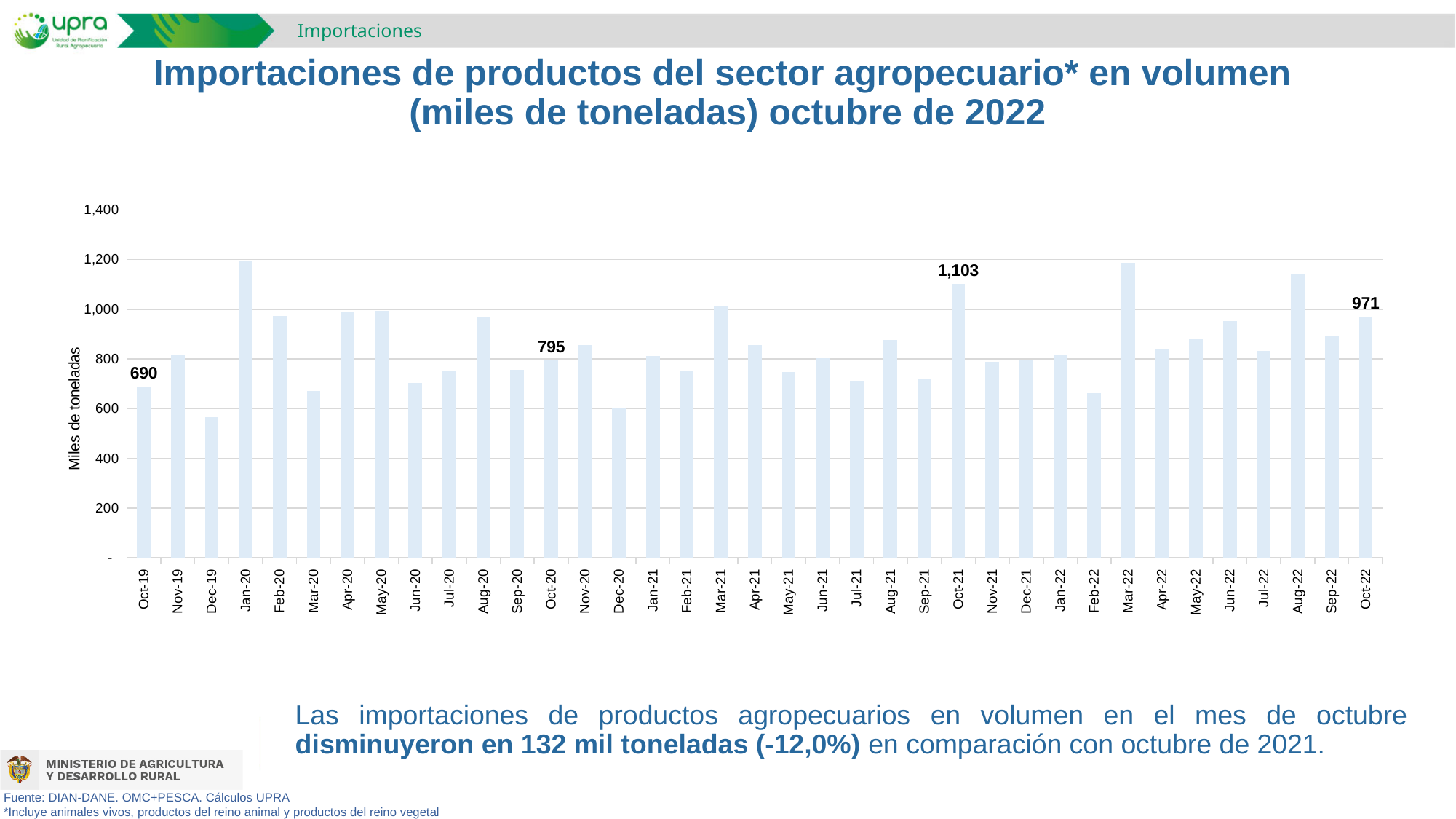
Which is larger, the value for Oct-21 or the value for Oct-22? Oct-21 What is the label of the vertical axis? Miles de toneladas What is the value for Oct-21? 1,103 What is the value for Oct-22? 971 What is the value for Oct-20? 795 What kind of chart is shown on the slide? bar chart What is the value for Oct-19? 690 Is the value for Jan-20 greater or less than 1,000? greater How many months (bars) are shown on the chart? 37 What is the difference between the values for Oct-21 and Oct-22? 132 What is the difference between the values for Oct-20 and Oct-19? 105 Is the value for Feb-22 greater or less than 800? less